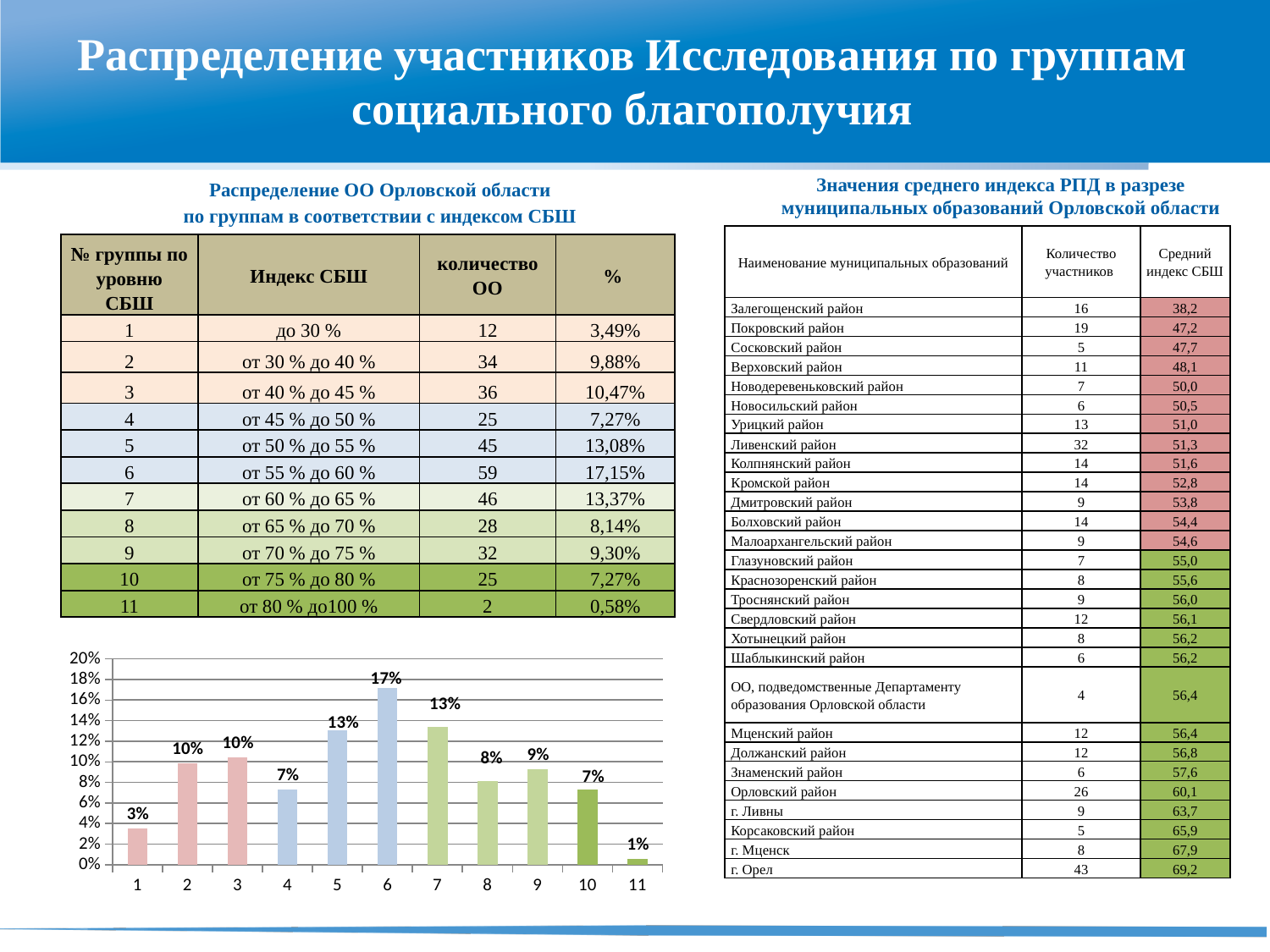
In the bar chart, which category has the highest value? 6 What type of chart is shown at the bottom left of the slide? bar chart In the bar chart, what is the highest value shown on the y axis? 20% In the bar chart, what is the data label for category 1? 3% In the bar chart, is the value for category 4 greater or less than 10%? less In the bar chart, which is larger, the value for category 5 or the value for category 8? category 5 In the bar chart, what is the data label for category 9? 9% In the bar chart, how many categories are plotted along the x axis? 11 In the bar chart, what is the difference between the data labels for category 6 and category 11? 16% In the bar chart, what is the data label for category 6? 17% In the bar chart, which category has the lowest value? 11 In the bar chart, is the value for category 6 greater or less than 16%? greater